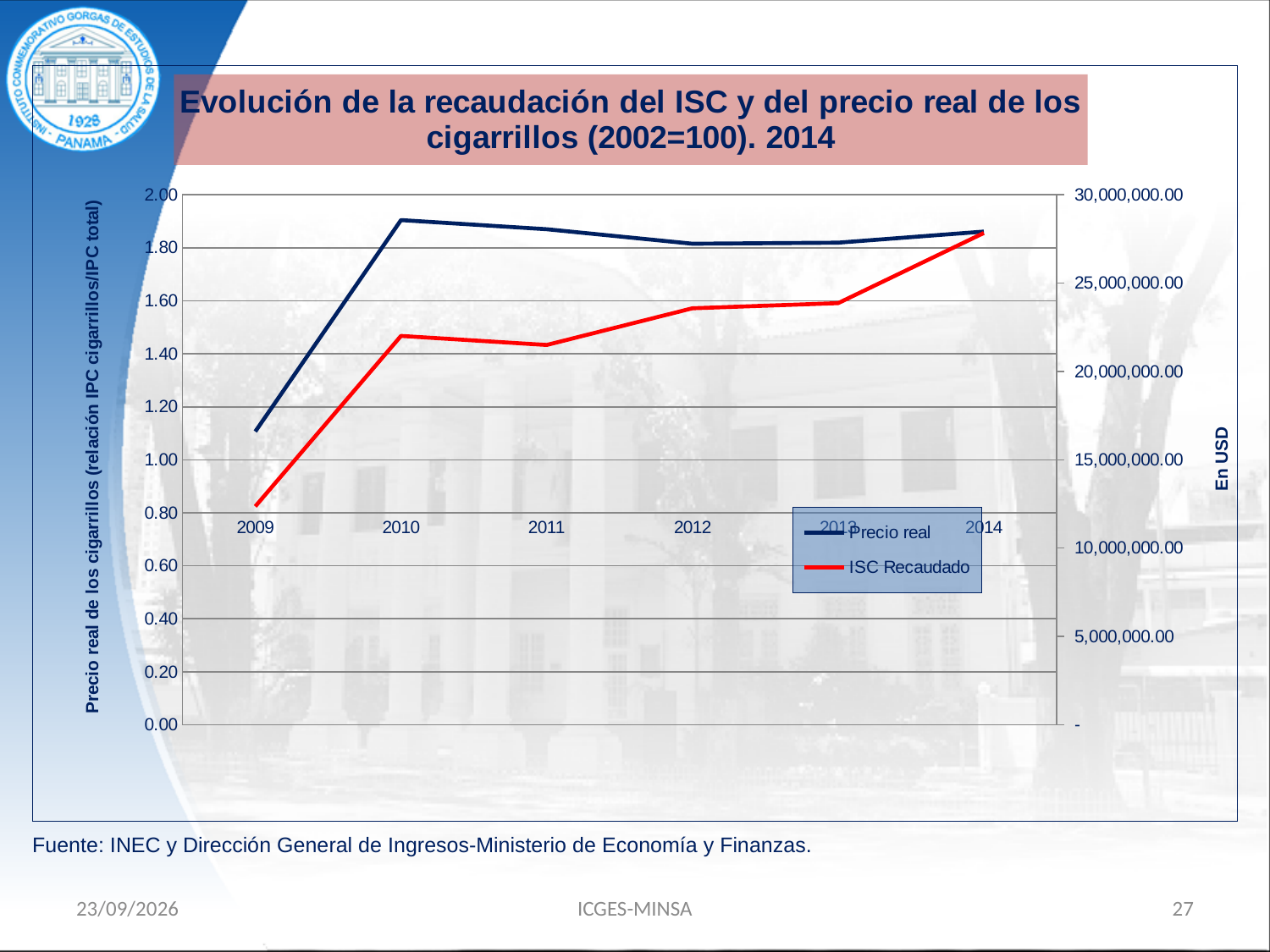
How many years are plotted along the x axis? 6 In which year is the Precio real series at its lowest? 2009 In which year is the ISC Recaudado series at its lowest? 2009 What kind of chart is shown on the slide? Line chart Which series is drawn in red? ISC Recaudado Is the Precio real value for 2010 greater or less than 1.80? greater Does the ISC Recaudado series rise or fall from 2009 to 2010? rise What is the label of the right-hand vertical axis? En USD Is the Precio real value for 2009 greater or less than 1.20? less In which year is the ISC Recaudado series at its highest? 2014 How many series does the legend list? 2 Is the ISC Recaudado value for 2014 greater or less than 25,000,000.00? greater